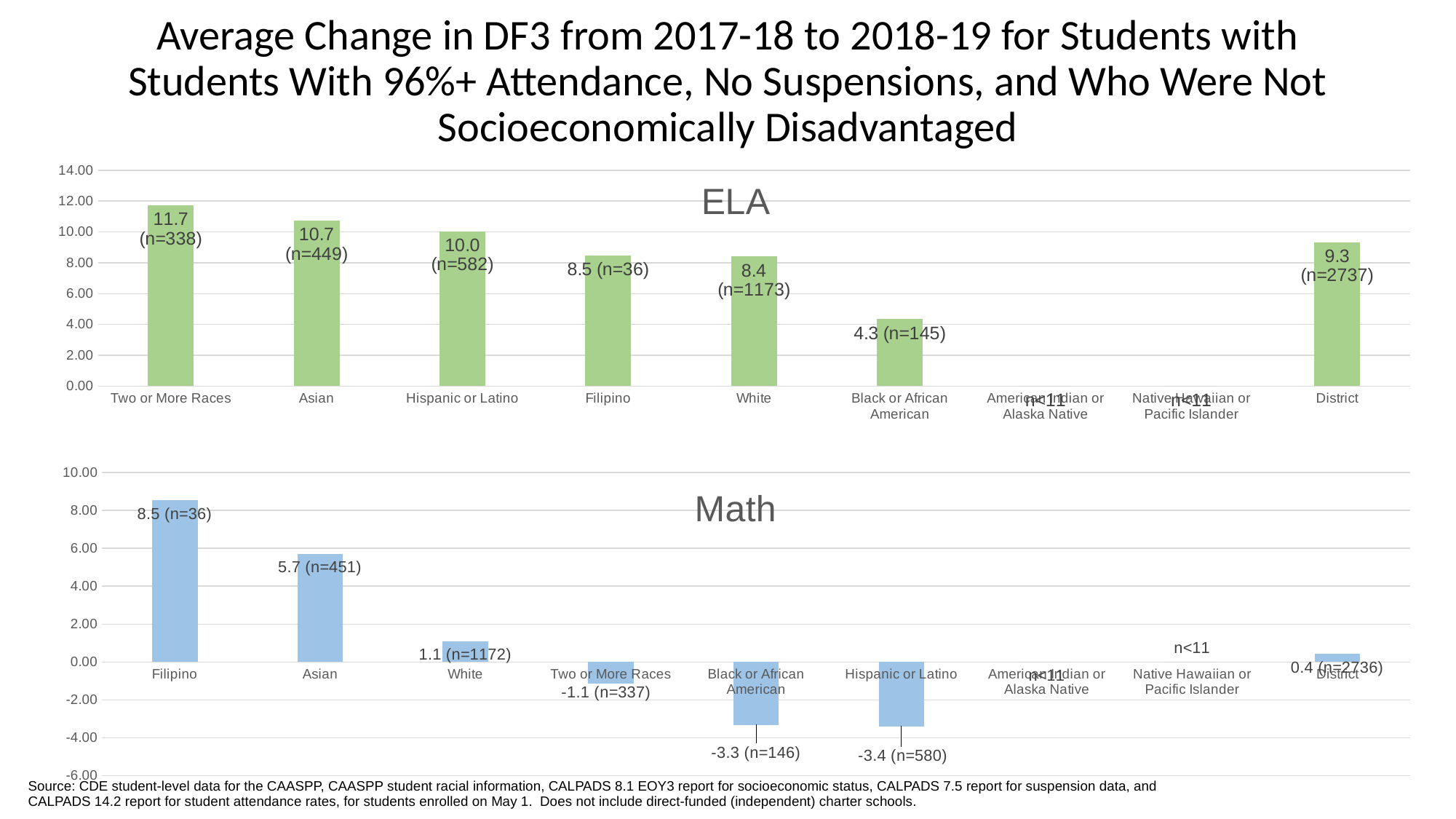
How many categories are listed on the x axis of the Math chart? 9 In the ELA chart, what is the difference between the values for Asian and White students? 2.3 In the ELA chart, what is shown for American Indian or Alaska Native instead of a bar? n<11 In the ELA chart, which category has the highest average change? Two or More Races In the Math chart, what is the average change in DF3 for Hispanic or Latino students? -3.4 In the ELA chart, what is the District value? 9.3 In the ELA chart, which plotted category has the lowest average change? Black or African American In the ELA chart, what is the average change in DF3 for Two or More Races? 11.7 What type of chart is the ELA chart? Bar chart In the Math chart, which category has the highest average change? Filipino In the Math chart, which is larger, the value for White students or the value for Two or More Races? White In the Math chart, what is the value for Asian students? 5.7